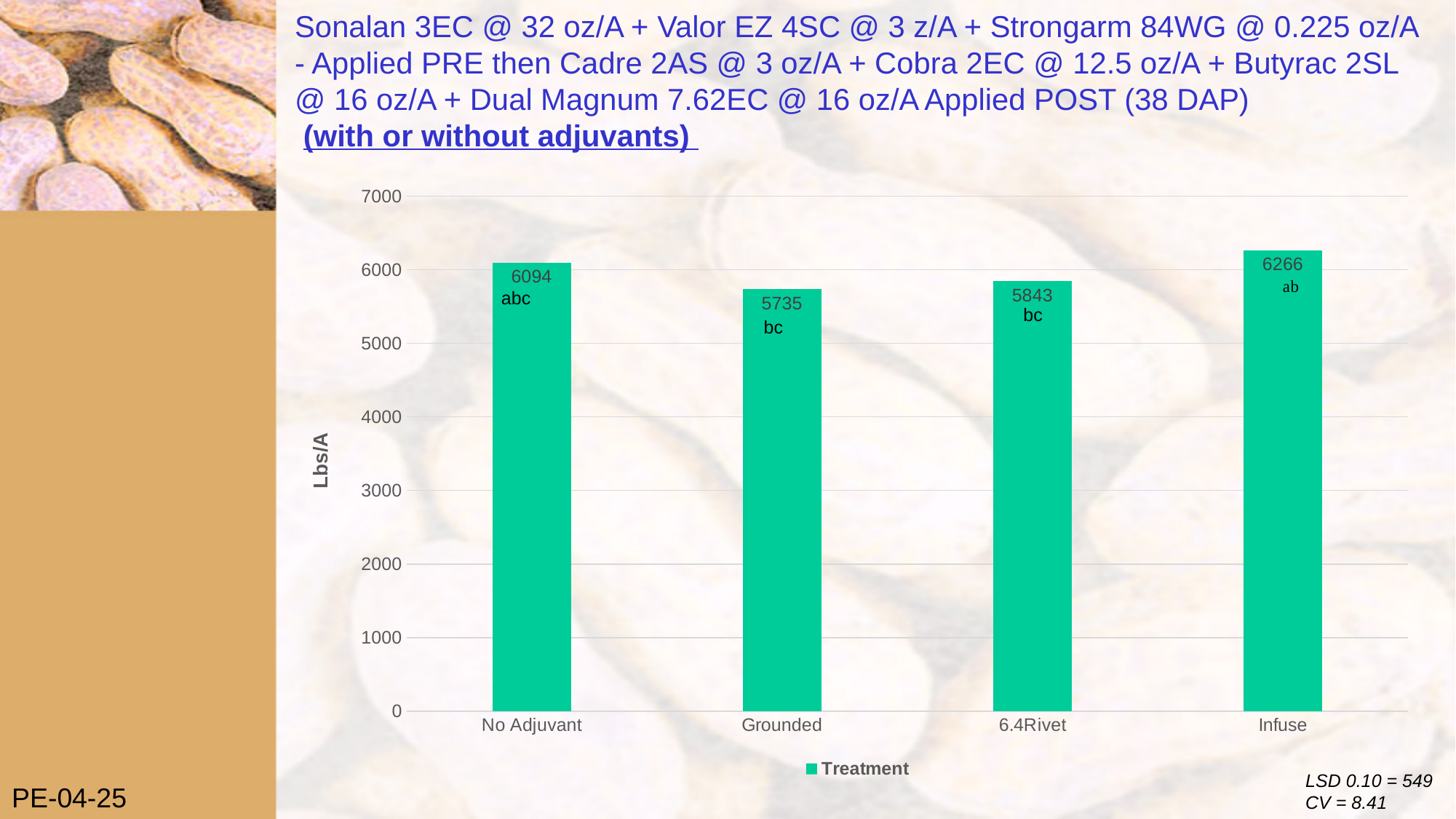
Which category has the highest value? Infuse How many categories are shown on the x axis? 4 What is the value for No Adjuvant? 6094 What kind of chart is shown on the slide? bar chart Which category has the lowest value? Grounded Which is larger, the value for No Adjuvant or the value for 6.4Rivet? No Adjuvant What is the label of the y axis? Lbs/A Is the value for Grounded greater or less than 6000? less What is the value for Infuse? 6266 What is the value for Grounded? 5735 What is the difference between the values for Infuse and Grounded? 531 What is the value for 6.4Rivet? 5843